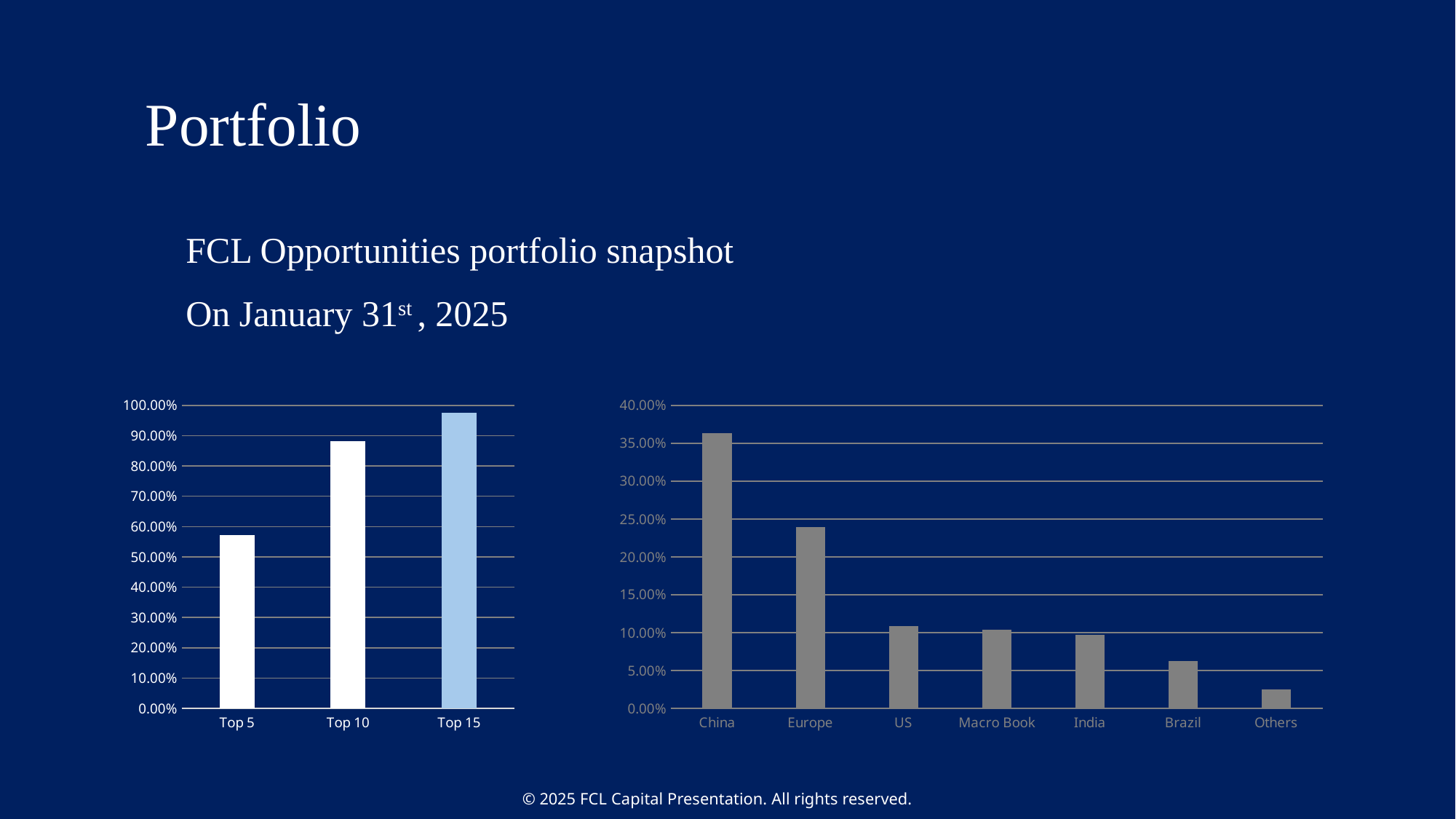
In the left chart, is the value for Top 5 greater or less than 50.00%? greater In the right chart, is the value for Others greater or less than 5.00%? less In the right chart, which category has the lowest value? Others What kind of chart is the left chart (Top 5 / Top 10 / Top 15)? bar chart In the right chart, which is larger, the value for Europe or the value for Brazil? Europe In the left chart, how many categories are shown on the x axis? 3 In the right chart, how many categories are shown on the x axis? 7 In the left chart, which category has the lowest value? Top 5 In the right chart, which category has the highest value? China What kind of chart is the right chart (China, Europe, US, ...)? bar chart In the right chart, is the value for China greater or less than 30.00%? greater In the left chart, which category has the highest value? Top 15